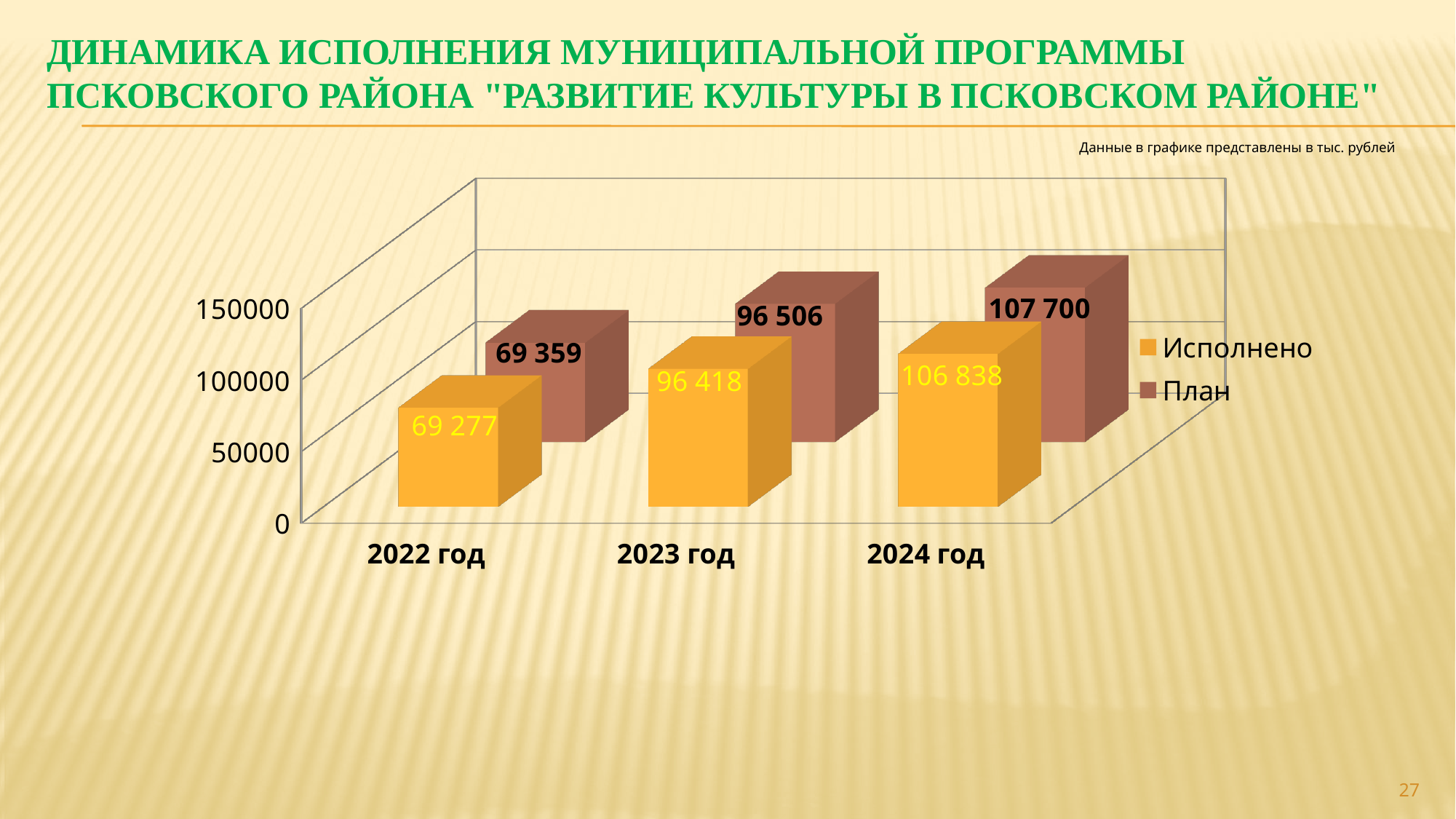
What is the value of Исполнено for 2024 год? 106 838 What is the value of План for 2023 год? 96 506 Which year has the highest План value? 2024 год How many series does the legend list? 2 How many years are shown on the x axis? 3 Which is larger: Исполнено for 2023 год or Исполнено for 2022 год? Исполнено for 2023 год Which year has the lowest Исполнено value? 2022 год What is the value of План for 2024 год? 107 700 What is the difference between Исполнено for 2023 год and Исполнено for 2022 год? 27 141 What is the difference between План and Исполнено for 2024 год? 862 Do the Исполнено values rise or fall from 2022 год to 2024 год? rise What is the value of Исполнено for 2022 год? 69 277